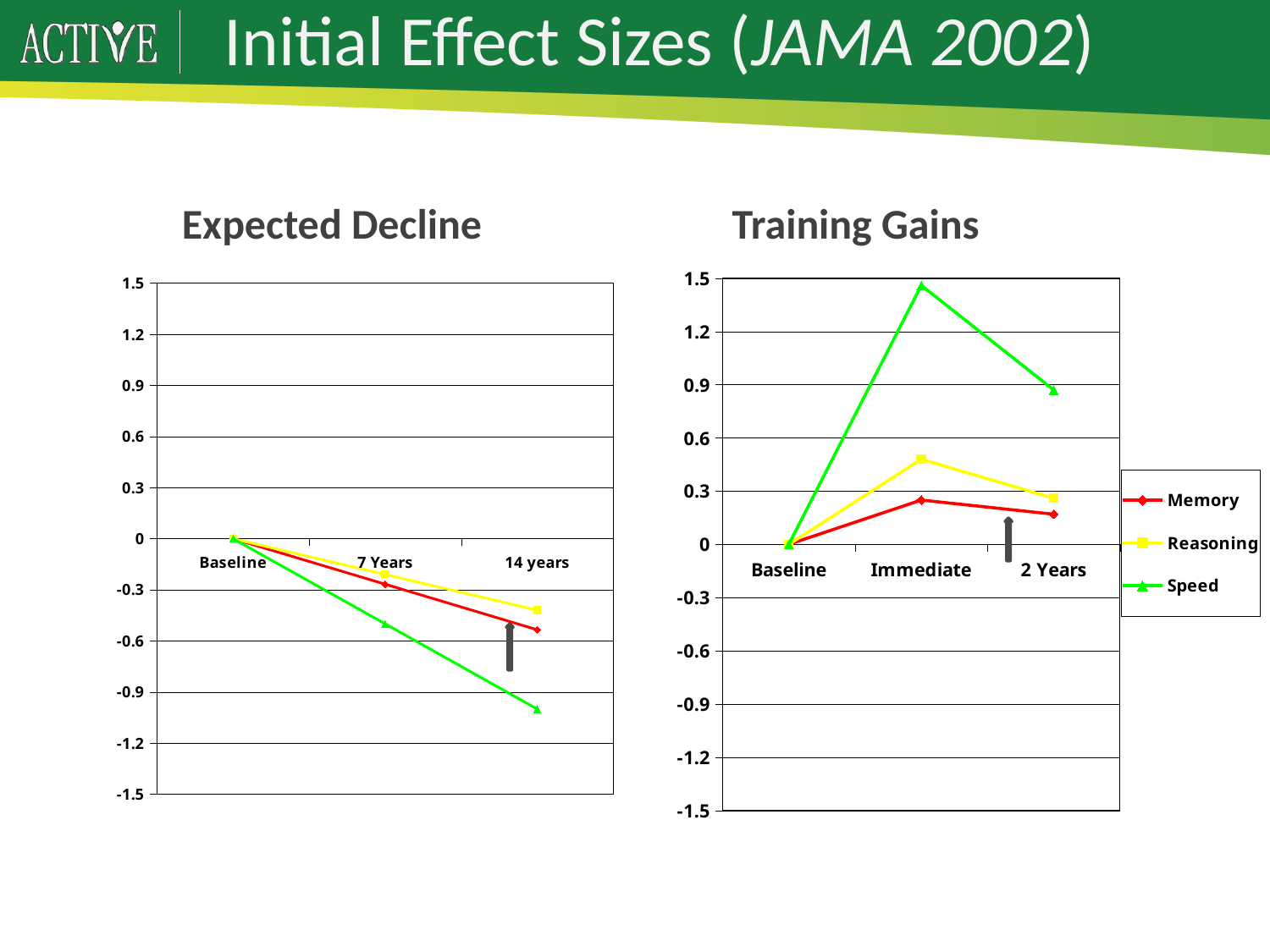
In the Training Gains chart, is the value for Speed at Immediate greater or less than 1.2? greater In the Expected Decline chart, which series has the lowest value at 14 years? Speed In the Expected Decline chart, does the Speed line rise or fall from Baseline to 14 years? fall What are the entries listed in the legend? Memory, Reasoning, Speed In the Training Gains chart, what is the value for Speed at Baseline? 0 How many categories are on the x axis of the Expected Decline chart? 3 How many series does the legend list? 3 In the Training Gains chart, which series has the highest value at Immediate? Speed In the Training Gains chart, is the value for Reasoning at Immediate greater or less than 0.6? less In the Training Gains chart, which is larger at 2 Years: Speed or Reasoning? Speed What kind of chart is the Expected Decline chart? line chart In the Expected Decline chart, is the value for Speed at 14 years greater or less than -0.9? less